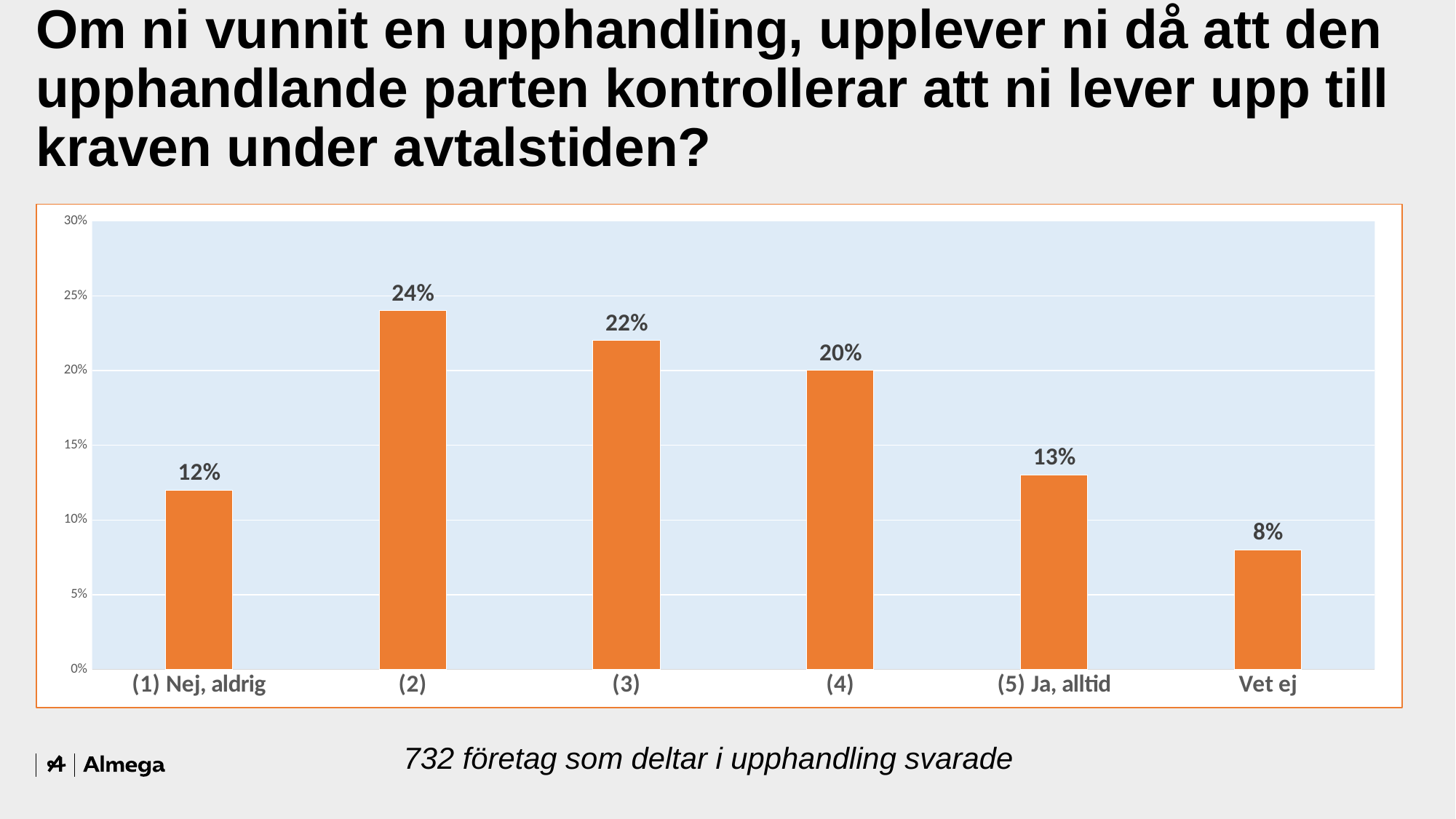
How many categories are shown on the x axis? 6 What is the value for "(5) Ja, alltid"? 13% What is the value for "Vet ej"? 8% What is the value for "(2)"? 24% What kind of chart is shown on the slide? bar chart Which category has the highest value? (2) What is the value for "(1) Nej, aldrig"? 12% What is the maximum value shown on the y axis? 30% Which is larger, the value for "(3)" or the value for "(5) Ja, alltid"? (3) Is the value for "(4)" greater or less than 15%? greater Which category has the lowest value? Vet ej What is the difference between the values for "(2)" and "(4)"? 4%